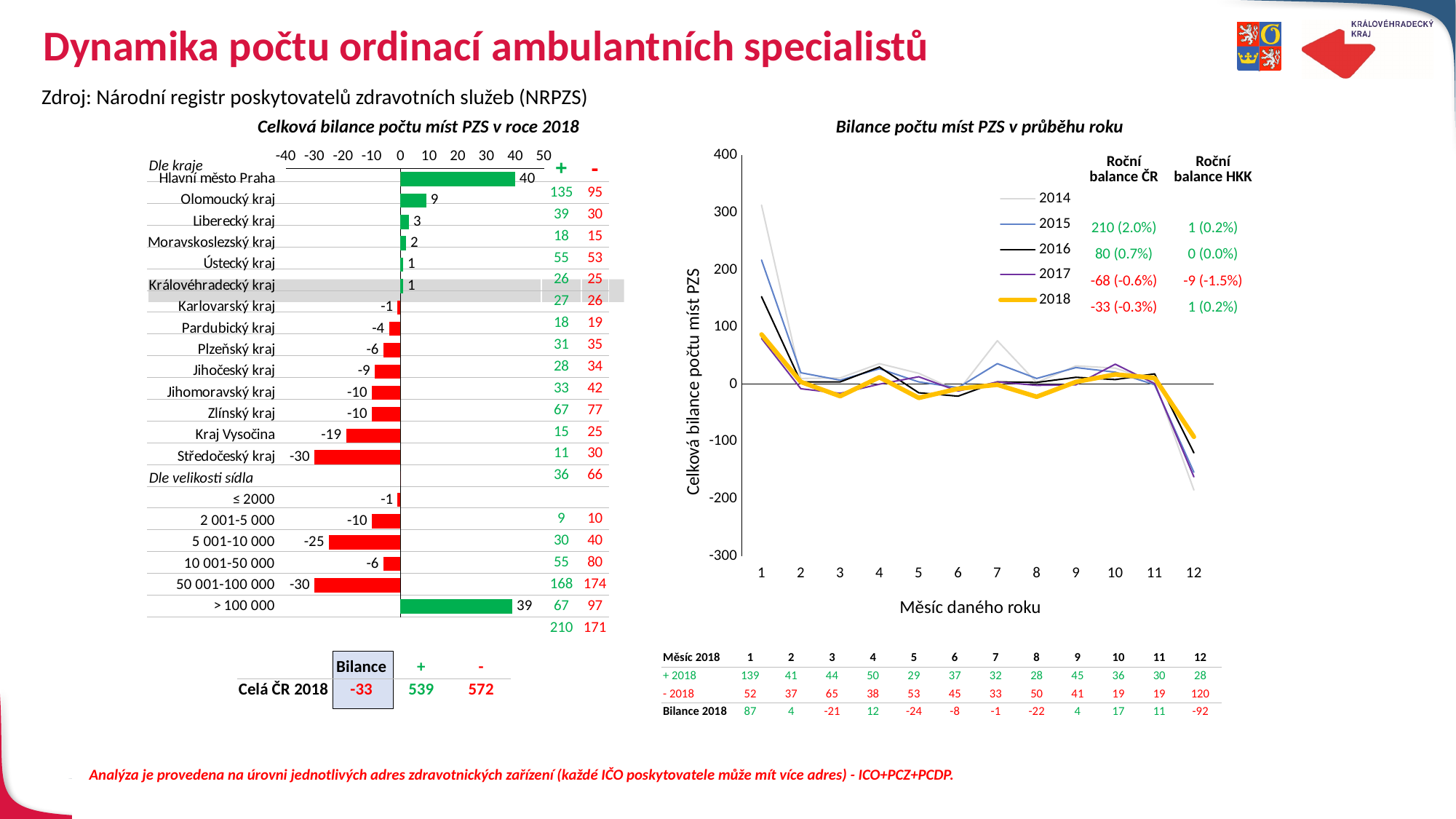
In the chart 'Bilance počtu míst PZS v průběhu roku', does the 2018 line rise or fall from month 11 to month 12? fall In the chart 'Celková bilance počtu míst PZS v roce 2018', what is the difference between the values for Hlavní město Praha and Olomoucký kraj? 31 In the chart 'Celková bilance počtu míst PZS v roce 2018', what is the value for Hlavní město Praha? 40 In the chart 'Celková bilance počtu míst PZS v roce 2018', what is the value for Středočeský kraj? -30 In the chart 'Bilance počtu míst PZS v průběhu roku', how many series does the legend list? 5 In the chart 'Bilance počtu míst PZS v průběhu roku', is the value for 2014 in month 1 greater or less than 200? greater What kind of chart is 'Celková bilance počtu míst PZS v roce 2018'? bar chart In the chart 'Celková bilance počtu míst PZS v roce 2018', which region (kraj) has the highest value? Hlavní město Praha In the chart 'Celková bilance počtu míst PZS v roce 2018', what is the value for the '> 100 000' settlement size category? 39 In the chart 'Celková bilance počtu míst PZS v roce 2018', which has the larger value, Kraj Vysočina or Jihočeský kraj? Jihočeský kraj In the chart 'Bilance počtu míst PZS v průběhu roku', how many months are shown on the x axis? 12 In the chart 'Celková bilance počtu míst PZS v roce 2018', which region (kraj) has the lowest value? Středočeský kraj